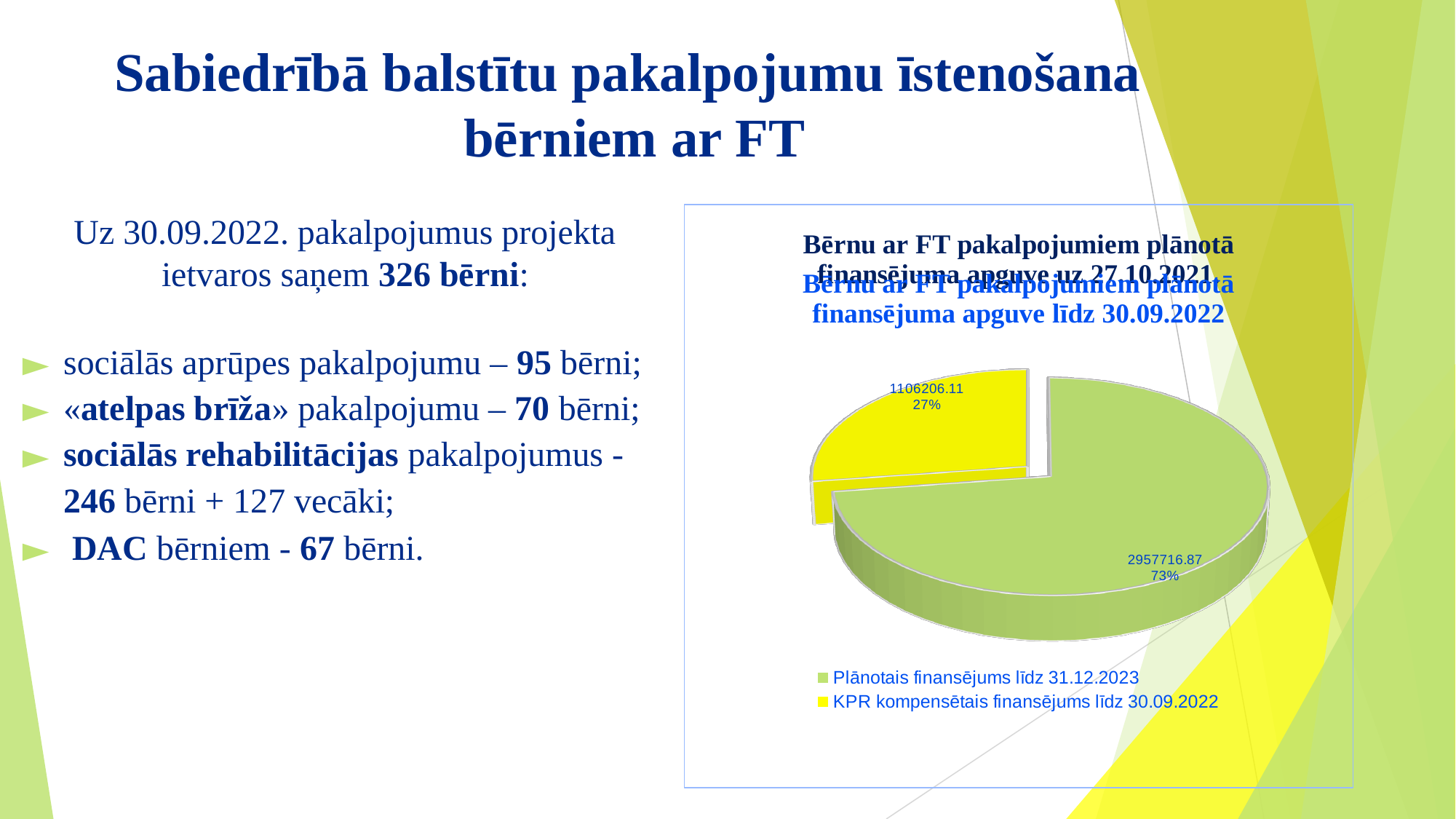
What percentage share does the KPR kompensētais finansējums līdz 30.09.2022 slice have? 27% Which slice of the pie chart is the smallest? KPR kompensētais finansējums līdz 30.09.2022 Which slice of the pie chart is the largest? Plānotais finansējums līdz 31.12.2023 Which is larger: Plānotais finansējums līdz 31.12.2023 or KPR kompensētais finansējums līdz 30.09.2022? Plānotais finansējums līdz 31.12.2023 What is the difference between the Plānotais finansējums līdz 31.12.2023 value and the KPR kompensētais finansējums līdz 30.09.2022 value? 1851510.76 What colour is the slice for KPR kompensētais finansējums līdz 30.09.2022? Yellow What kind of chart is shown on the slide? Pie chart How many slices does the pie chart have? 2 What value is shown for the slice labelled Plānotais finansējums līdz 31.12.2023? 2957716.87 How many entries does the chart legend list? 2 What percentage share does the Plānotais finansējums līdz 31.12.2023 slice have? 73% What value is shown for the slice labelled KPR kompensētais finansējums līdz 30.09.2022? 1106206.11